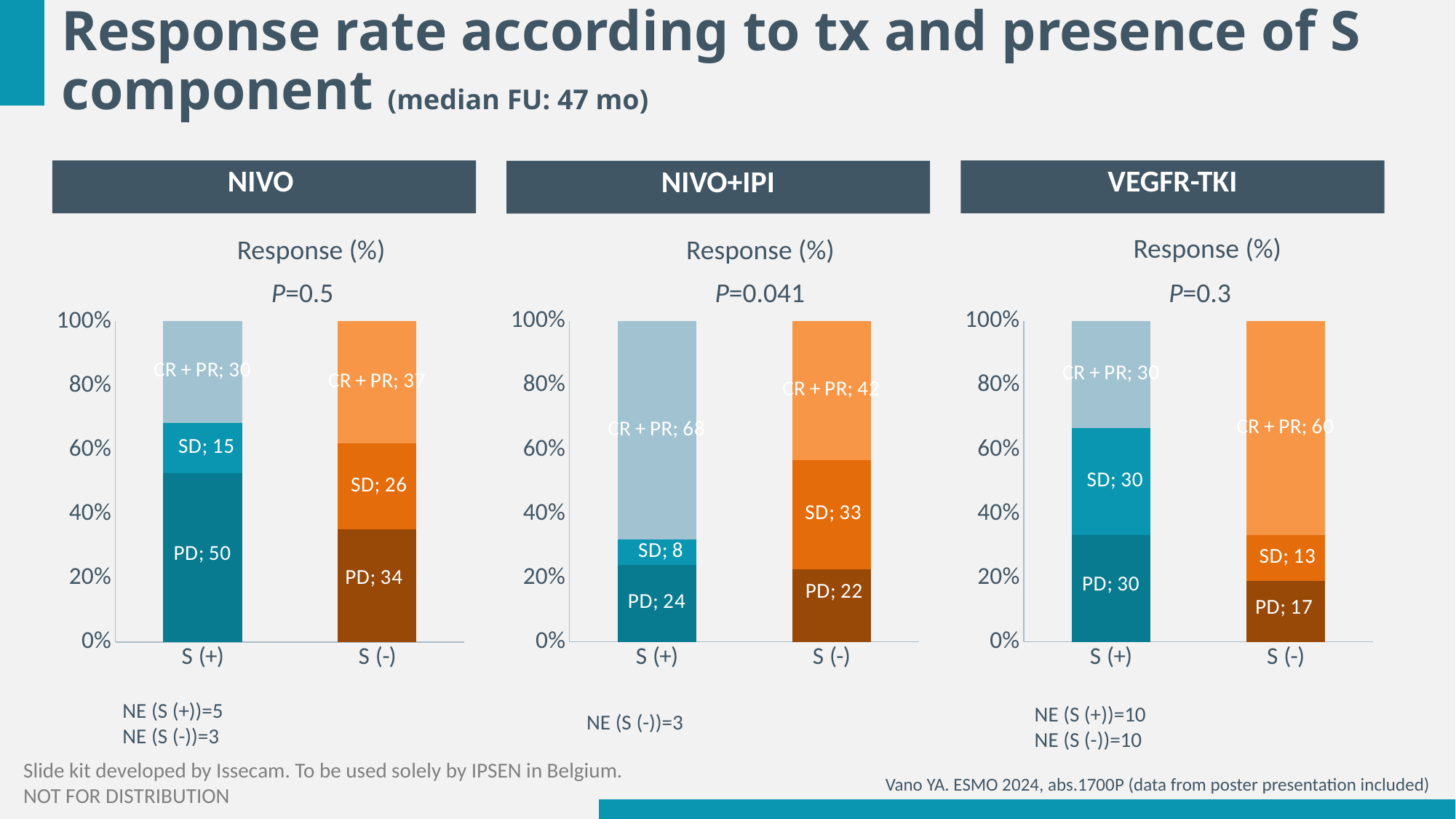
In the NIVO+IPI chart, which has the larger CR + PR value, S (+) or S (-)? S (+) What kind of chart is used in the NIVO panel? Stacked bar chart In the NIVO chart, what is the difference between the CR + PR values for S (-) and S (+)? 7 In the VEGFR-TKI chart, what is the PD value for S (-)? 17 In the NIVO+IPI chart, which has the larger SD value, S (+) or S (-)? S (-) In the VEGFR-TKI chart, what is the difference between the CR + PR values for S (-) and S (+)? 30 What P value is shown above the NIVO+IPI chart? P=0.041 How many categories are shown on the x axis of the VEGFR-TKI chart? 2 In the VEGFR-TKI chart, what is the SD value for S (-)? 13 In the NIVO chart, what is the difference between the PD values for S (+) and S (-)? 16 In the NIVO chart, what is the PD value for S (+)? 50 In the NIVO+IPI chart, what is the CR + PR value for S (+)? 68